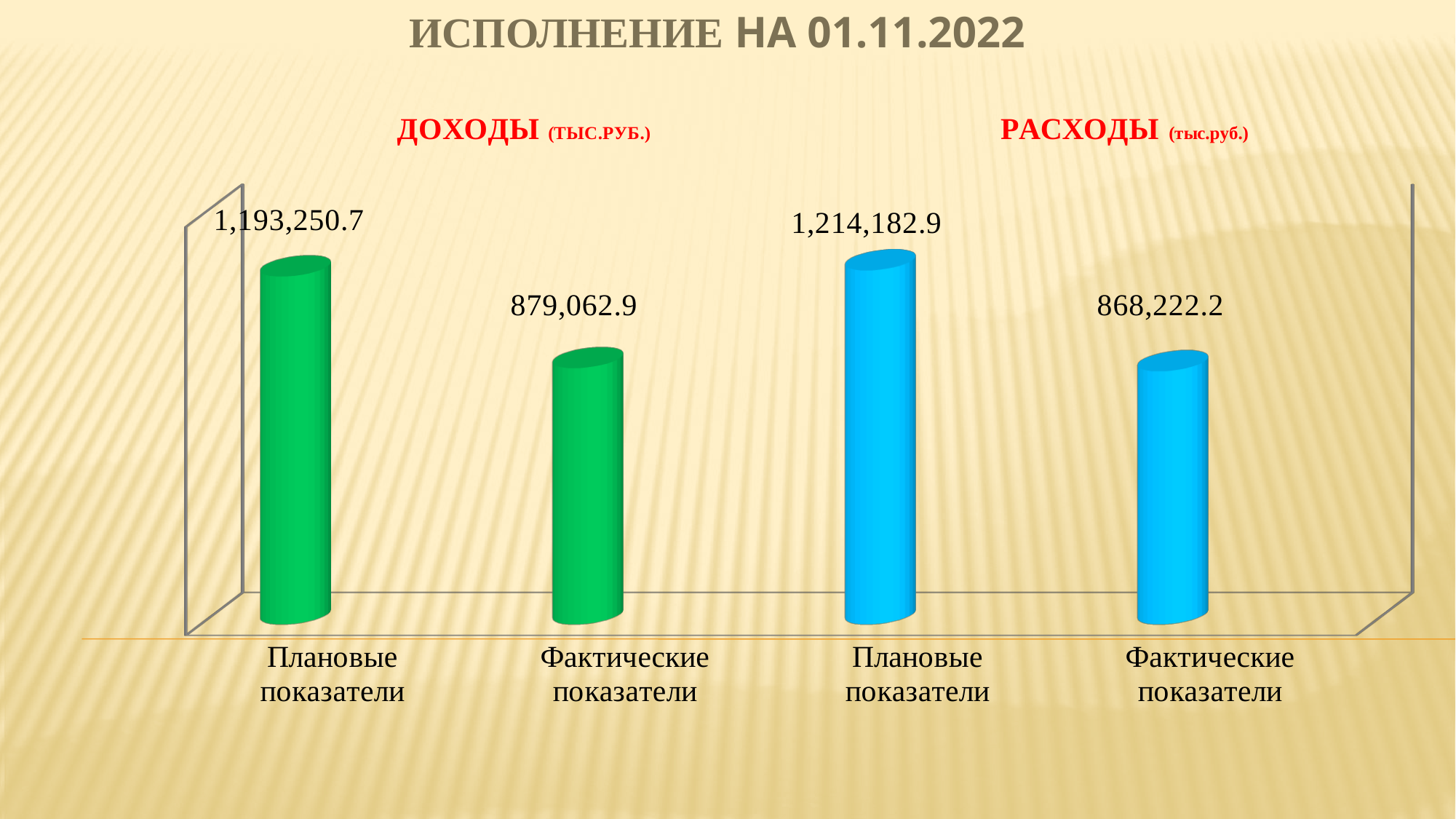
What is the value of the Фактические показатели bar under ДОХОДЫ? 879,062.9 What is the difference between the Плановые показатели and Фактические показатели values under ДОХОДЫ? 314,187.8 What is the difference between the Плановые показатели and Фактические показатели values under РАСХОДЫ? 345,960.7 Which bar has the lowest value on the chart? Фактические показатели (РАСХОДЫ) What is the value of the Плановые показатели bar under РАСХОДЫ? 1,214,182.9 How many bars are plotted on the chart? 4 What is the value of the Плановые показатели bar under ДОХОДЫ? 1,193,250.7 What is the title of the slide? ИСПОЛНЕНИЕ НА 01.11.2022 What is the value of the Фактические показатели bar under РАСХОДЫ? 868,222.2 What kind of chart is shown on the slide? Bar chart Which is larger: the Плановые показатели value under ДОХОДЫ or the Плановые показатели value under РАСХОДЫ? Плановые показатели under РАСХОДЫ Which bar has the highest value on the chart? Плановые показатели (РАСХОДЫ)